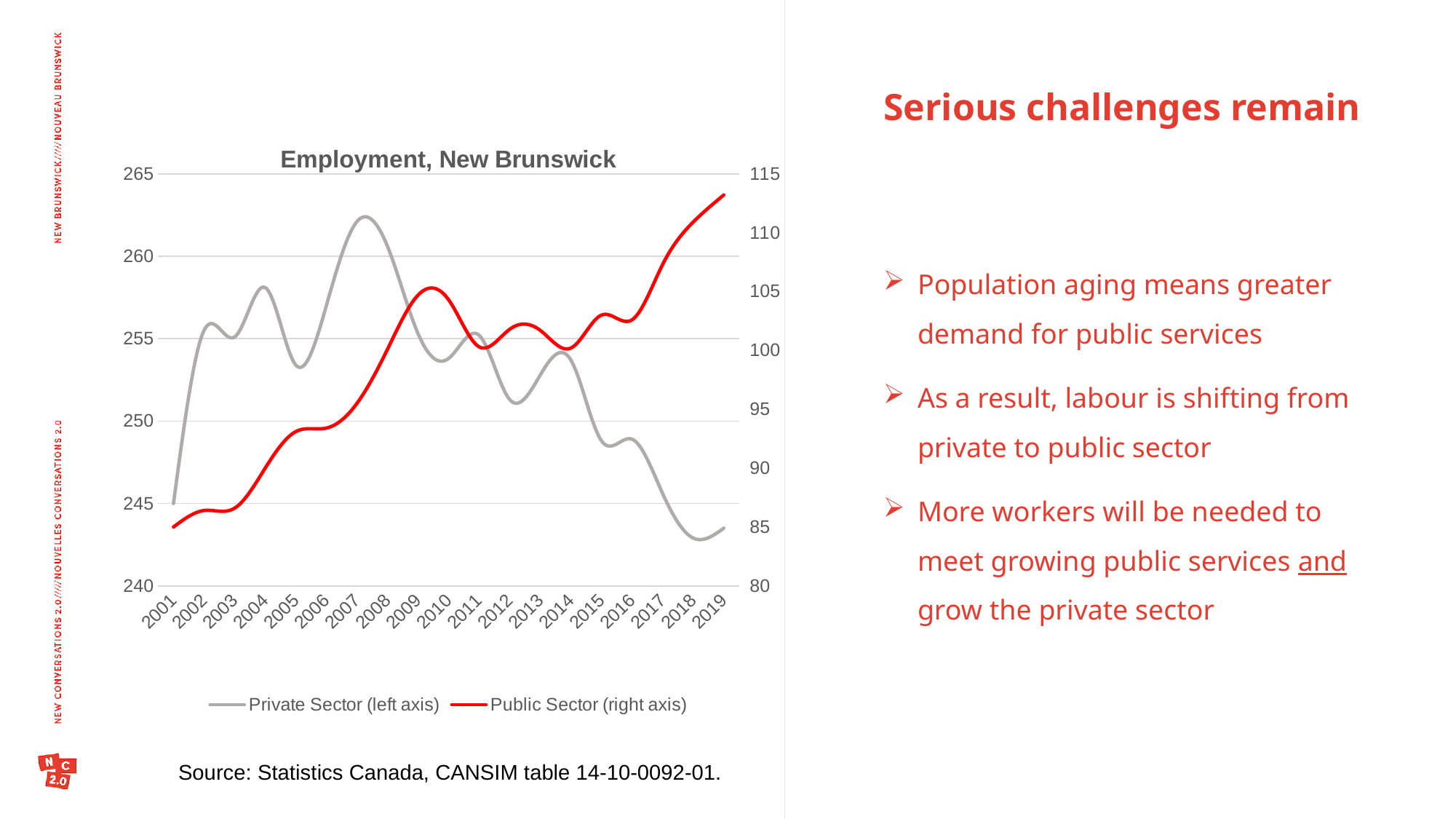
In which year does the Public Sector series reach its highest value? 2019 In which year does the Private Sector series reach its highest value? 2007 How many years are plotted along the x axis of the chart? 19 What kind of chart is shown on the slide? Line chart How many series does the chart's legend list? 2 Which series is plotted against the right axis? Public Sector Does the Public Sector series generally rise or fall from 2001 to 2019? Rise What is the title of the chart? Employment, New Brunswick Is the Public Sector value for 2019 greater or less than 110? greater In which year is the Public Sector series at its lowest? 2001 Is the Private Sector value for 2007 greater or less than 260? greater Is the Public Sector value for 2001 greater or less than 90? less